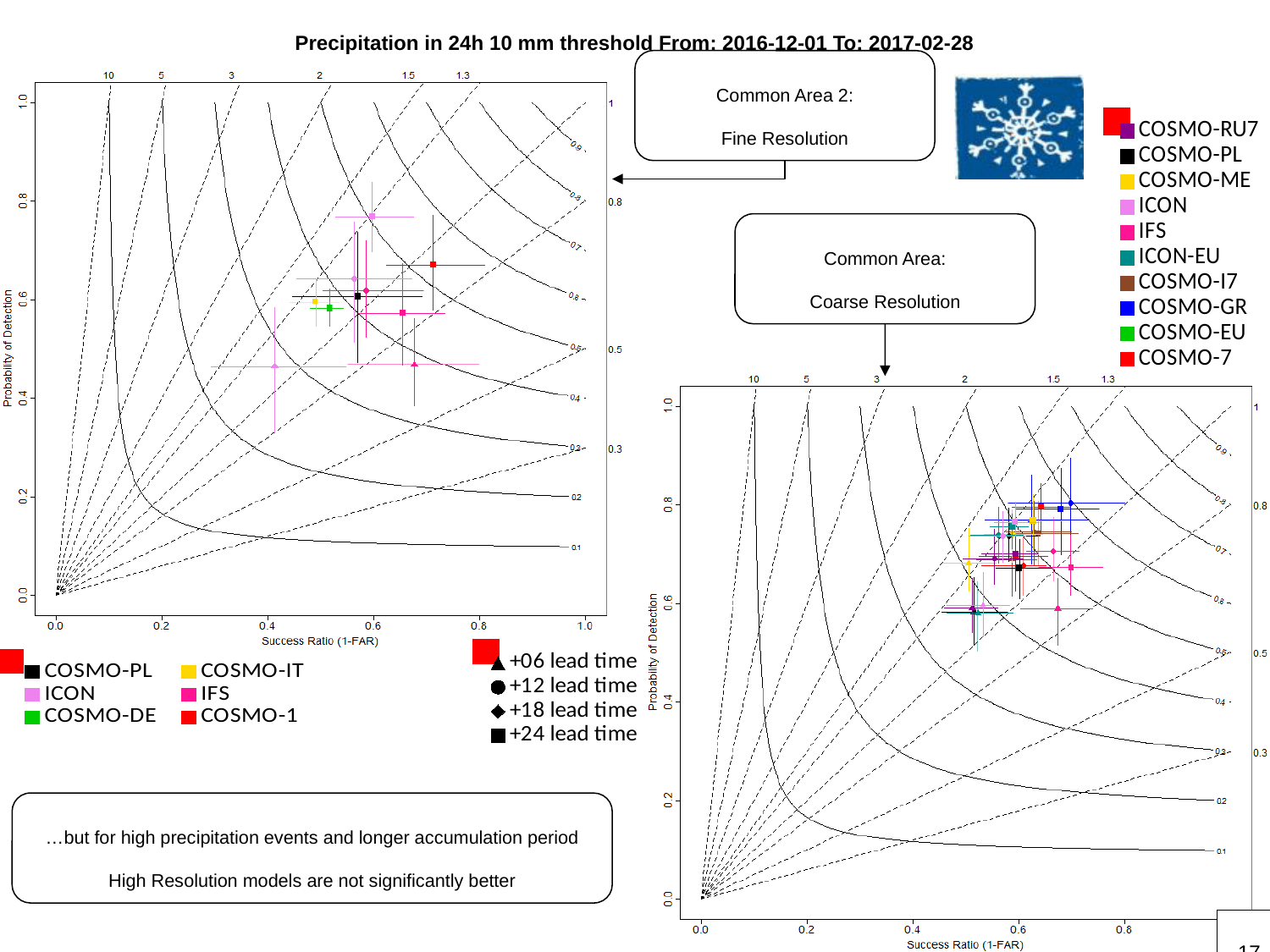
In the left chart (Common Area 2: Fine Resolution), is the highest plotted Success Ratio greater or less than 0.8? less In the right chart (Common Area: Coarse Resolution), is the lowest plotted Success Ratio greater or less than 0.4? greater In the left chart (Common Area 2: Fine Resolution), is the highest plotted Probability of Detection greater or less than 0.8? less What kind of chart is the left chart (Common Area 2: Fine Resolution)? scatter plot How many lead times are listed in the marker-shape legend on the slide? 4 What is the title printed above the charts on the slide? Precipitation in 24h 10 mm threshold From: 2016-12-01 To: 2017-02-28 How many models does the legend list for the left chart (Common Area 2: Fine Resolution)? 6 What is the label of the x axis on the right chart (Common Area: Coarse Resolution)? Success Ratio (1-FAR) How many models does the legend list for the right chart (Common Area: Coarse Resolution)? 10 What is the maximum value shown on the Probability of Detection axis of the right chart (Common Area: Coarse Resolution)? 1.0